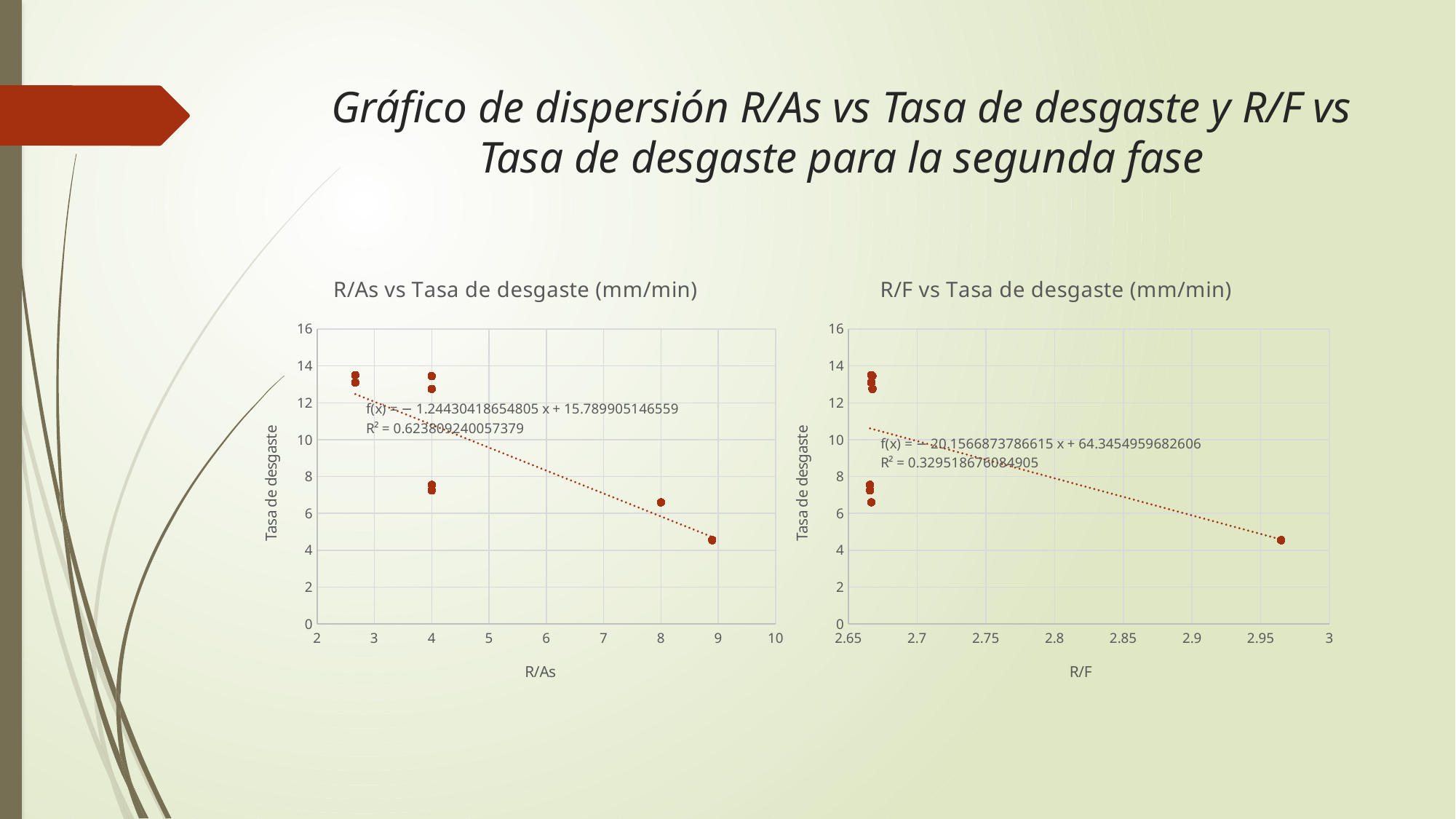
In the left chart 'R/As vs Tasa de desgaste (mm/min)', what is the trendline equation printed on the chart? f(x) = − 1.24430418654805 x + 15.789905146559 What is the y-axis label of the left chart? Tasa de desgaste In the left chart 'R/As vs Tasa de desgaste (mm/min)', what is the R² value printed on the chart? 0.623809240057379 In the right chart 'R/F vs Tasa de desgaste (mm/min)', what is the trendline equation printed on the chart? f(x) = − 20.1566873786615 x + 64.3454959682606 In the right chart 'R/F vs Tasa de desgaste (mm/min)', does the trendline rise or fall as R/F increases? fall In the left chart 'R/As vs Tasa de desgaste (mm/min)', does the trendline rise or fall as R/As increases? fall In the right chart 'R/F vs Tasa de desgaste (mm/min)', what is the R² value printed on the chart? 0.329518676084905 In the left chart 'R/As vs Tasa de desgaste (mm/min)', is the wear rate of the point at R/As ≈ 9 greater or less than 6? less What kind of chart is the right chart, 'R/F vs Tasa de desgaste (mm/min)'? scatter chart In the right chart 'R/F vs Tasa de desgaste (mm/min)', is the wear rate of the point near R/F ≈ 2.97 greater or less than 6? less What kind of chart is the left chart, 'R/As vs Tasa de desgaste (mm/min)'? scatter chart What is the x-axis label of the right chart? R/F